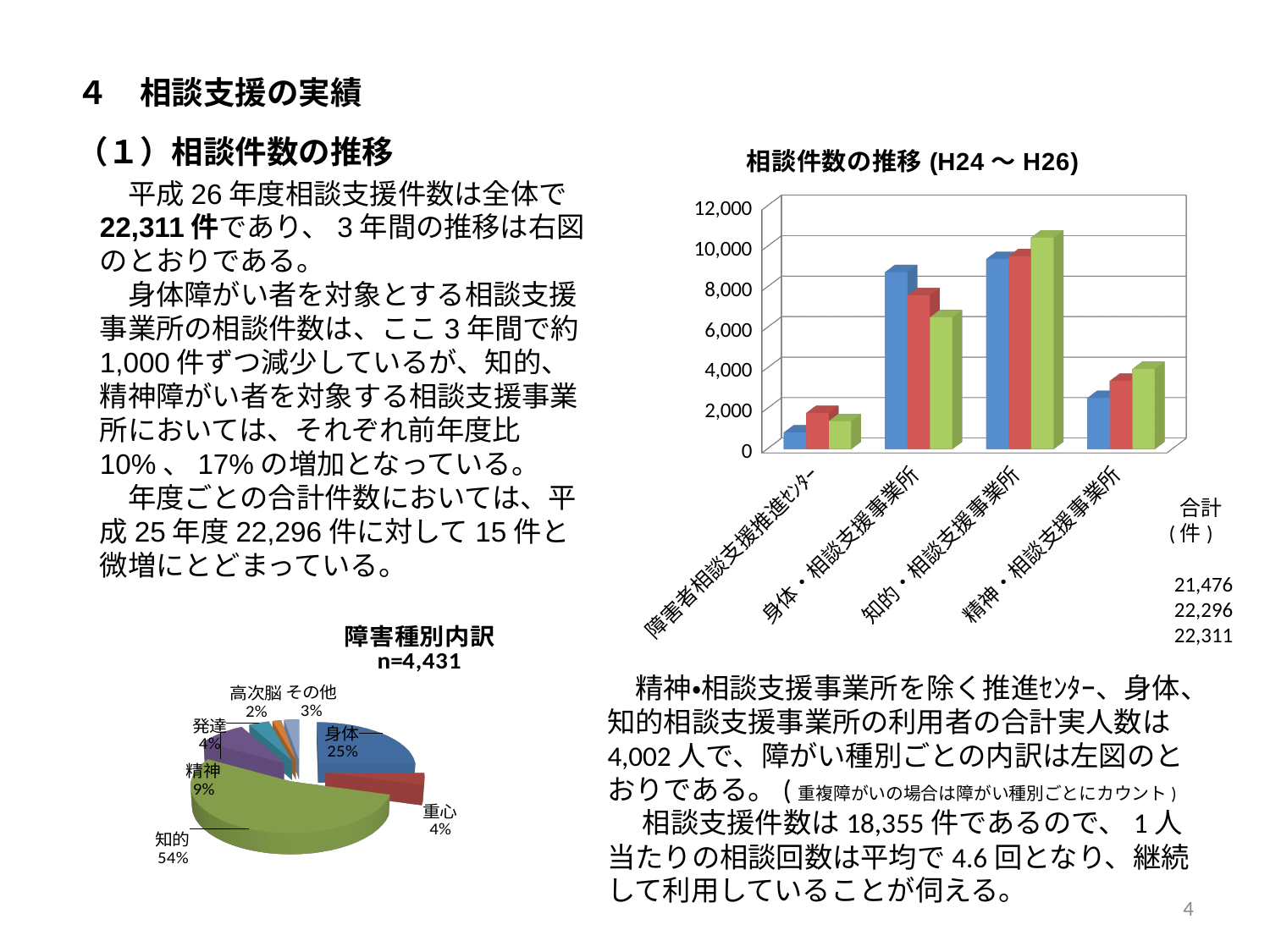
In the chart titled 相談件数の推移 (H24 ～ H26), how many categories are shown on the x axis? 4 In the pie chart titled 障害種別内訳, how many slices are there? 7 In the chart titled 相談件数の推移 (H24 ～ H26), is the first (blue) bar for 身体・相談支援事業所 greater or less than 8,000? greater What kind of chart is the chart titled 相談件数の推移 (H24 ～ H26)? bar chart In the pie chart titled 障害種別内訳, which slice is the smallest? 高次脳 In the chart titled 相談件数の推移 (H24 ～ H26), do the three bars for 身体・相談支援事業所 rise or fall from left to right? fall In the chart titled 相談件数の推移 (H24 ～ H26), which category has the shortest bars? 障害者相談支援推進センター In the pie chart titled 障害種別内訳, which slice is the largest? 知的 In the pie chart titled 障害種別内訳, what share does 身体 have? 25% In the chart titled 相談件数の推移 (H24 ～ H26), is the third (green) bar for 知的・相談支援事業所 greater or less than 10,000? greater In the pie chart titled 障害種別内訳, what share does 精神 have? 9% In the chart titled 相談件数の推移 (H24 ～ H26), which category has the tallest bars? 知的・相談支援事業所